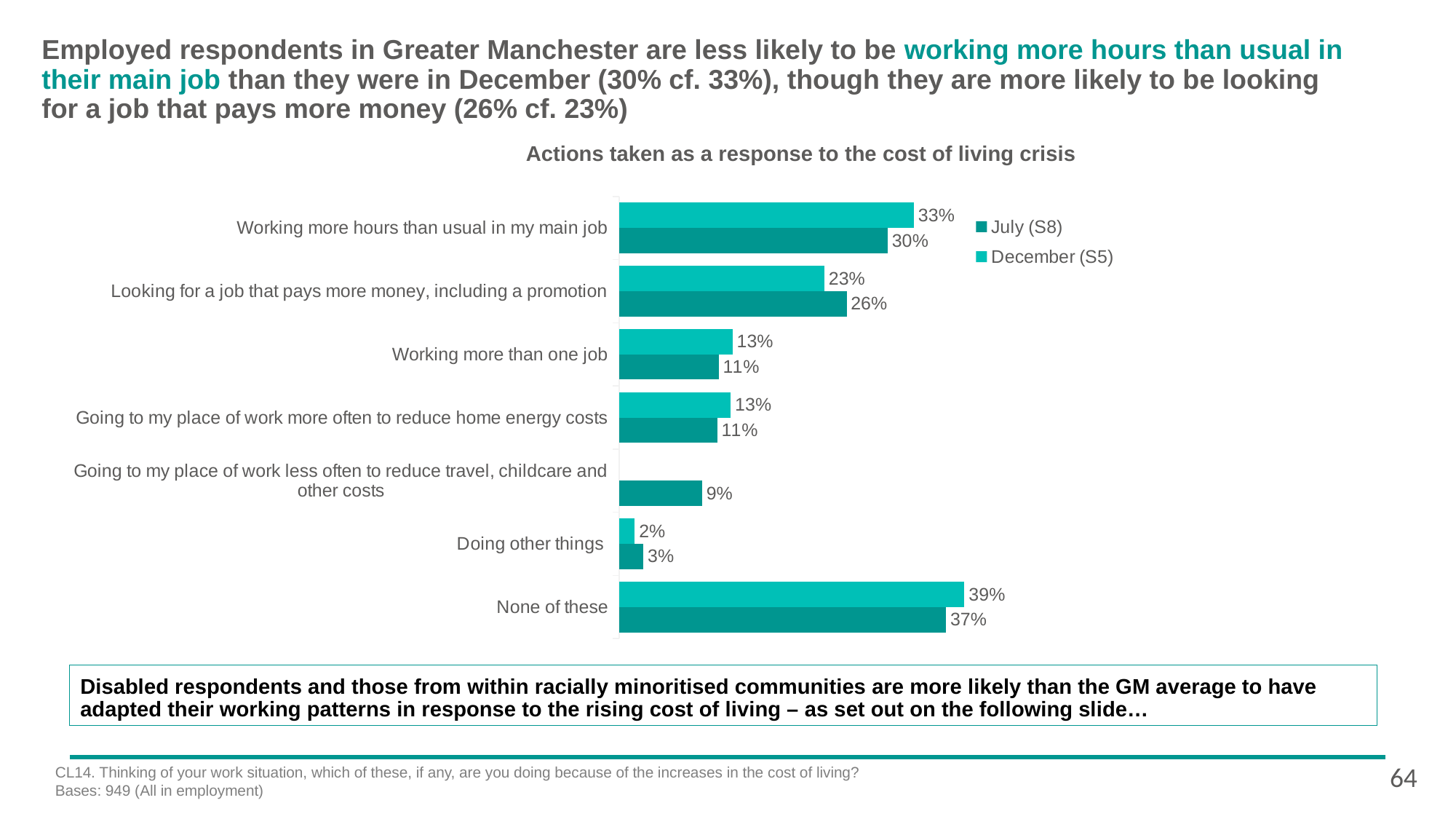
What is the July (S8) value for 'Going to my place of work less often to reduce travel, childcare and other costs'? 9% What is the July (S8) value for 'None of these'? 37% What is the July (S8) value for 'Working more hours than usual in my main job'? 30% For 'Looking for a job that pays more money, including a promotion', which is larger: the July (S8) value or the December (S5) value? July (S8) How many series does the legend list? 2 Which category has the lowest July (S8) value? Doing other things Which category has the highest December (S5) value? None of these How many categories are shown on the chart? 7 What is the December (S5) value for 'Looking for a job that pays more money, including a promotion'? 23% What kind of chart is shown on the slide? Bar chart What is the difference between the December (S5) and July (S8) values for 'Working more than one job'? 2% What is the title of the chart? Actions taken as a response to the cost of living crisis